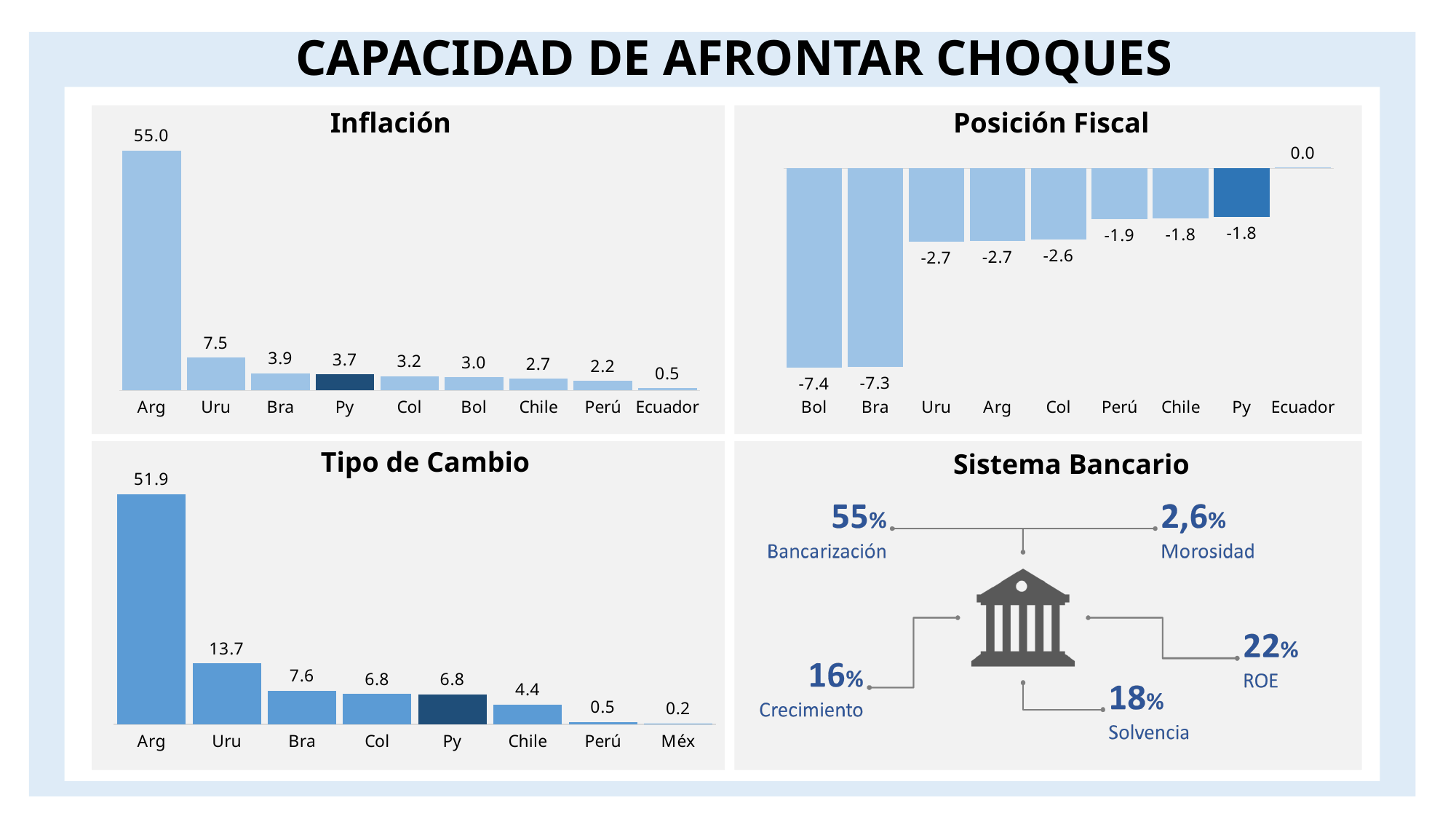
In the Tipo de Cambio chart, which is larger, the value for Bra or the value for Chile? Bra In the Inflación chart, what is the difference between the values for Uru and Py? 3.8 In the Posición Fiscal chart, which category has the highest value? Ecuador In the Inflación chart, which category has the lowest value? Ecuador In the Posición Fiscal chart, what is the value for Py? -1.8 In the Inflación chart, what is the value for Arg? 55.0 In the Posición Fiscal chart, what is the value for Bol? -7.4 What kind of chart is the Tipo de Cambio chart? Bar chart In the Tipo de Cambio chart, what is the difference between the values for Arg and Uru? 38.2 In the Tipo de Cambio chart, what is the value for Uru? 13.7 In the Tipo de Cambio chart, how many categories are shown? 8 In the Inflación chart, how many categories are shown? 9